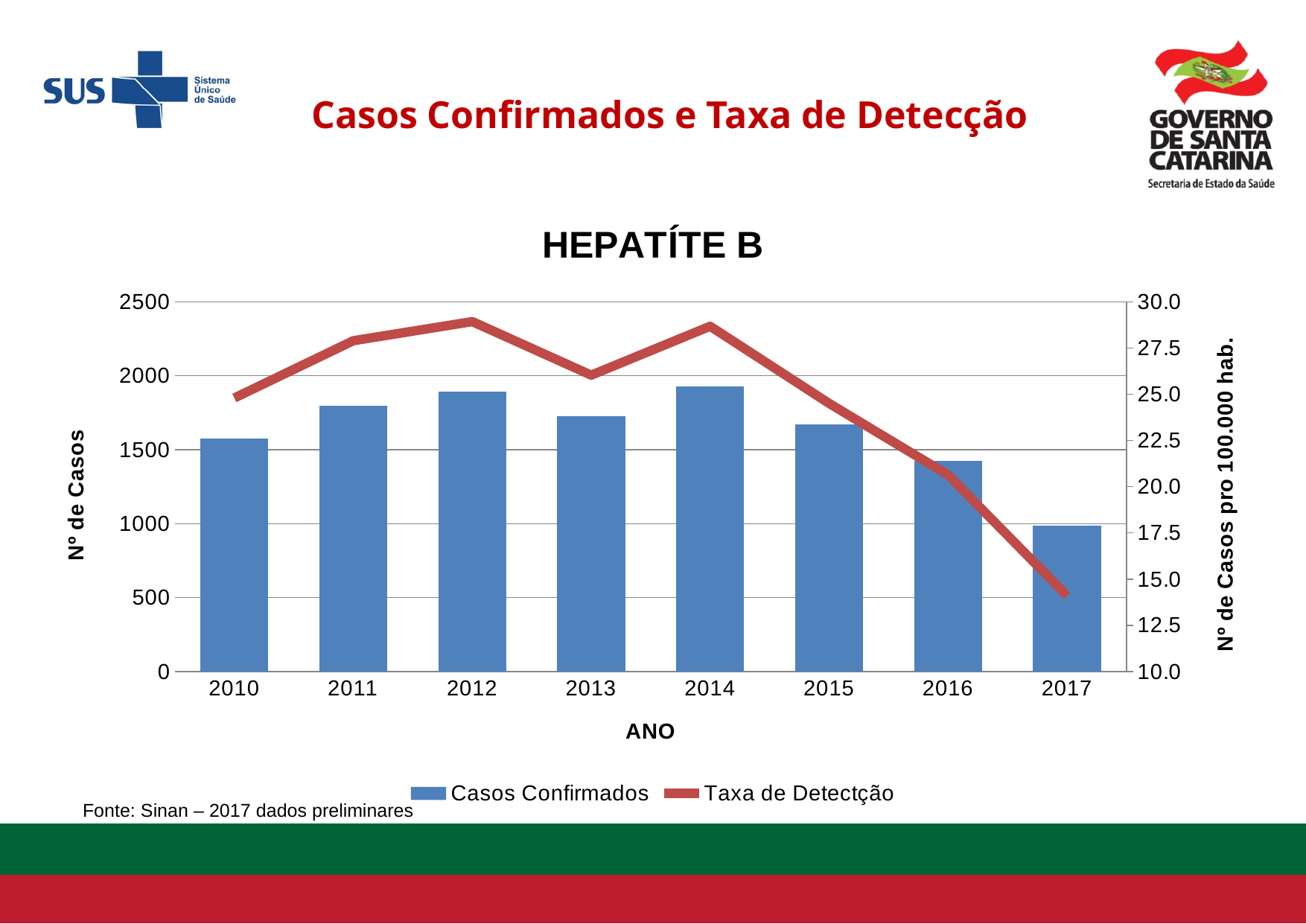
Which year has the lowest detection rate (Taxa de Detectção)? 2017 Is the number of confirmed cases in 2014 greater or less than 1500? greater Is the detection rate in 2012 greater or less than 27.5? greater How many years are shown on the x axis of the chart? 8 Which year has more confirmed cases, 2011 or 2016? 2011 Is the detection rate in 2017 greater or less than 15.0? less What is the title of the chart? HEPATÍTE B How many series does the legend list? 2 Does the detection rate rise or fall from 2014 to 2017? It falls Which year has the lowest number of confirmed cases (Casos Confirmados)? 2017 What kind of chart is shown on the slide? A combined bar and line chart